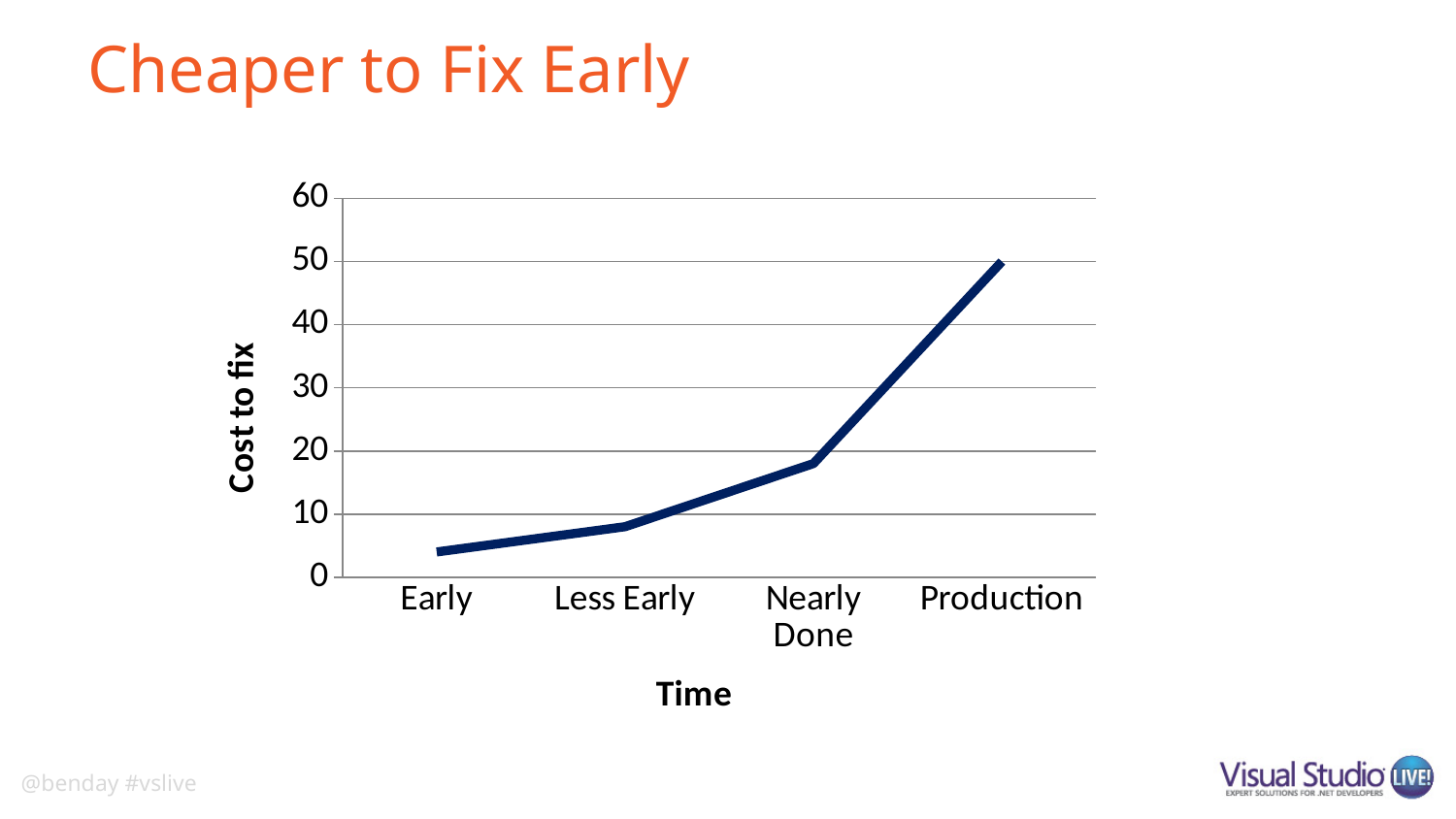
What is the label of the x axis? Time Is the value for Nearly Done greater or less than 10? greater What kind of chart is shown on the slide? line chart Which category has the lowest cost to fix? Early Is the value for Production greater or less than 40? greater Do the values rise or fall from Early to Production? rise Is the value for Less Early greater or less than 10? less What is the label of the y axis? Cost to fix Which has a higher cost to fix, Nearly Done or Less Early? Nearly Done How many categories are shown on the x axis? 4 Which category has the highest cost to fix? Production